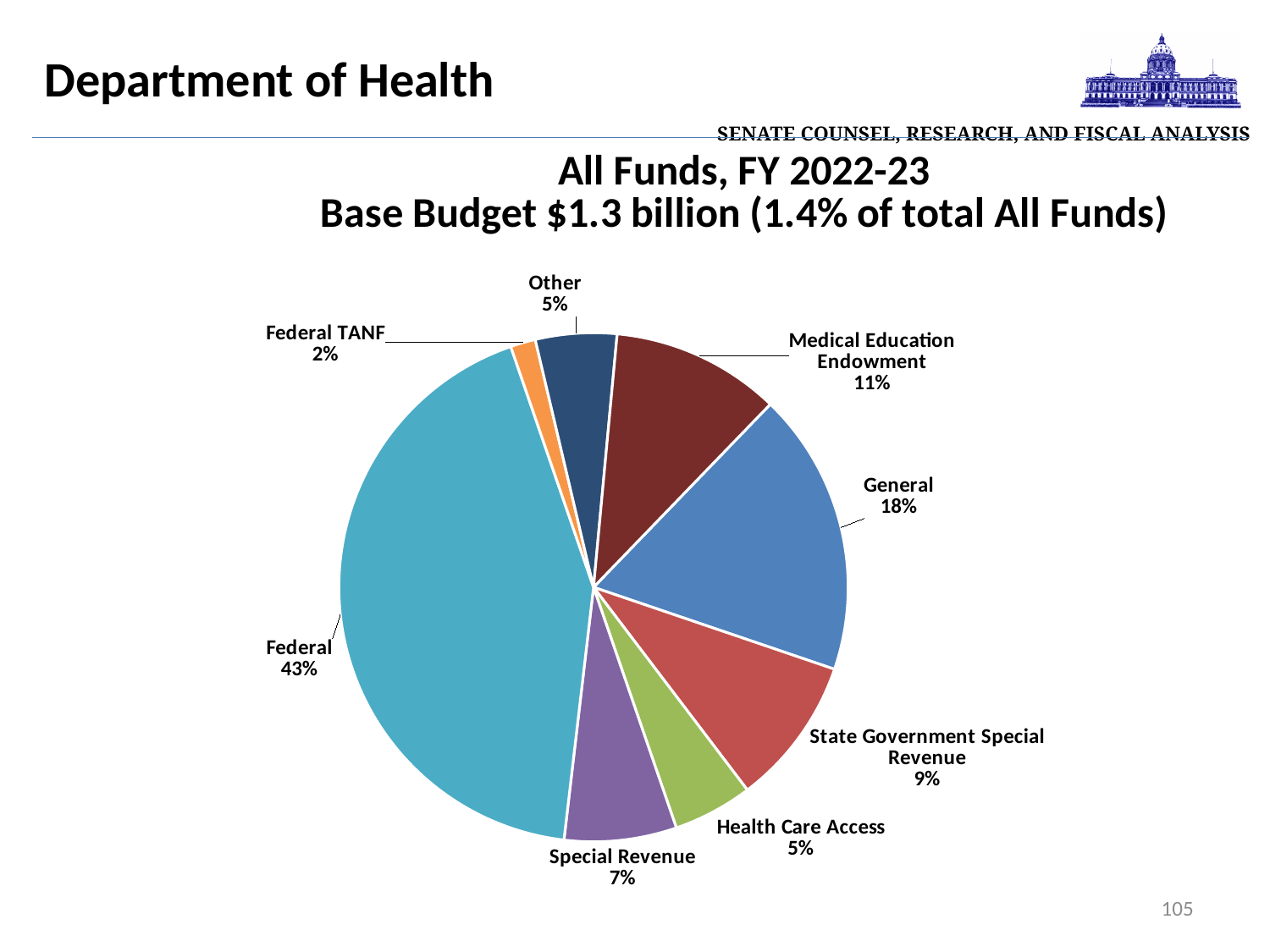
What share of the pie does General represent? 18% What kind of chart is shown on the slide? Pie chart What is the difference in percentage points between the Federal and General slices? 25 Which category has the smallest slice of the pie? Federal TANF How many slices does the pie chart have? 8 What share of the pie does Medical Education Endowment represent? 11% Which category has the largest slice of the pie? Federal What share of the pie does State Government Special Revenue represent? 9% Which is larger, the Special Revenue slice or the Health Care Access slice? Special Revenue What is the title of the chart? All Funds, FY 2022-23 Base Budget $1.3 billion (1.4% of total All Funds)